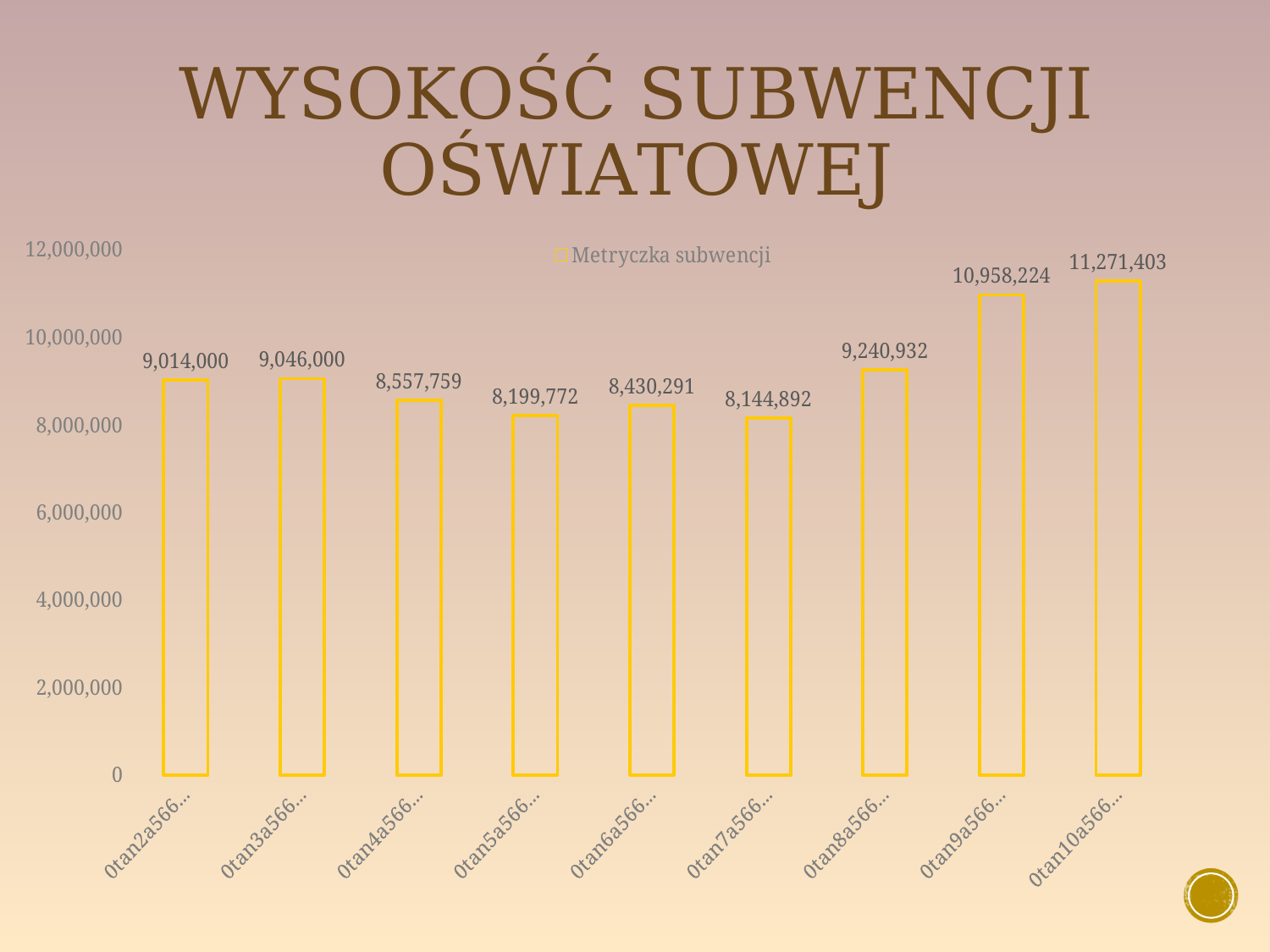
What is the difference between the rightmost bar and the leftmost bar? 2,257,403 What type of chart is shown on the slide? bar chart What is the value of the rightmost bar? 11,271,403 How many series does the chart legend list? 1 What is the value of the first bar from the left? 9,014,000 What is the name of the series shown in the chart legend? Metryczka subwencji What is the lowest value shown in the chart? 8,144,892 How many bars are plotted in the chart? 9 Which is larger, the value of the third bar from the left or the value of the fifth bar from the left? the third bar (8,557,759) Is the value of the eighth bar from the left greater or less than 10,000,000? greater What is the value of the seventh bar from the left? 9,240,932 What is the highest value shown in the chart? 11,271,403